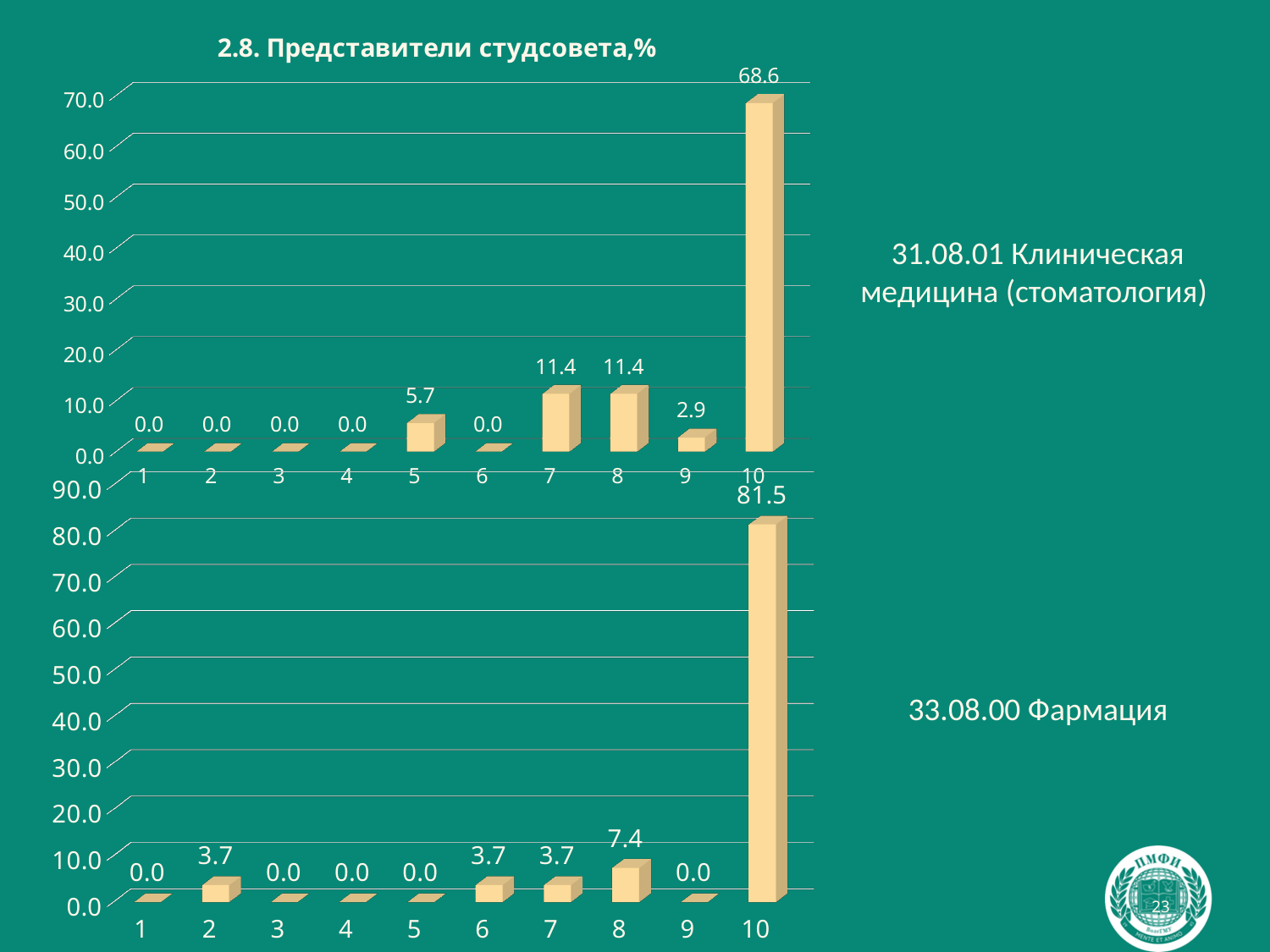
In the top chart (31.08.01 Клиническая медицина (стоматология)), what is the value for category 5? 5.7 In the bottom chart (33.08.00 Фармация), which category has the highest value? 10 In the top chart (31.08.01 Клиническая медицина (стоматология)), which category has the highest value? 10 What type of chart is the top chart (31.08.01 Клиническая медицина (стоматология))? bar chart How many categories are shown on the x axis of the bottom chart (33.08.00 Фармация)? 10 In the top chart (31.08.01 Клиническая медицина (стоматология)), what is the difference between the values for category 7 and category 9? 8.5 In the bottom chart (33.08.00 Фармация), what is the value for category 8? 7.4 In the bottom chart (33.08.00 Фармация), how many categories have a value of 0.0? 5 In the bottom chart (33.08.00 Фармация), what is the value for category 10? 81.5 In the top chart (31.08.01 Клиническая медицина (стоматология)), what is the value for category 10? 68.6 In the top chart (31.08.01 Клиническая медицина (стоматология)), which is larger: the value for category 5 or category 9? category 5 In the bottom chart (33.08.00 Фармация), what is the difference between the values for category 10 and category 8? 74.1